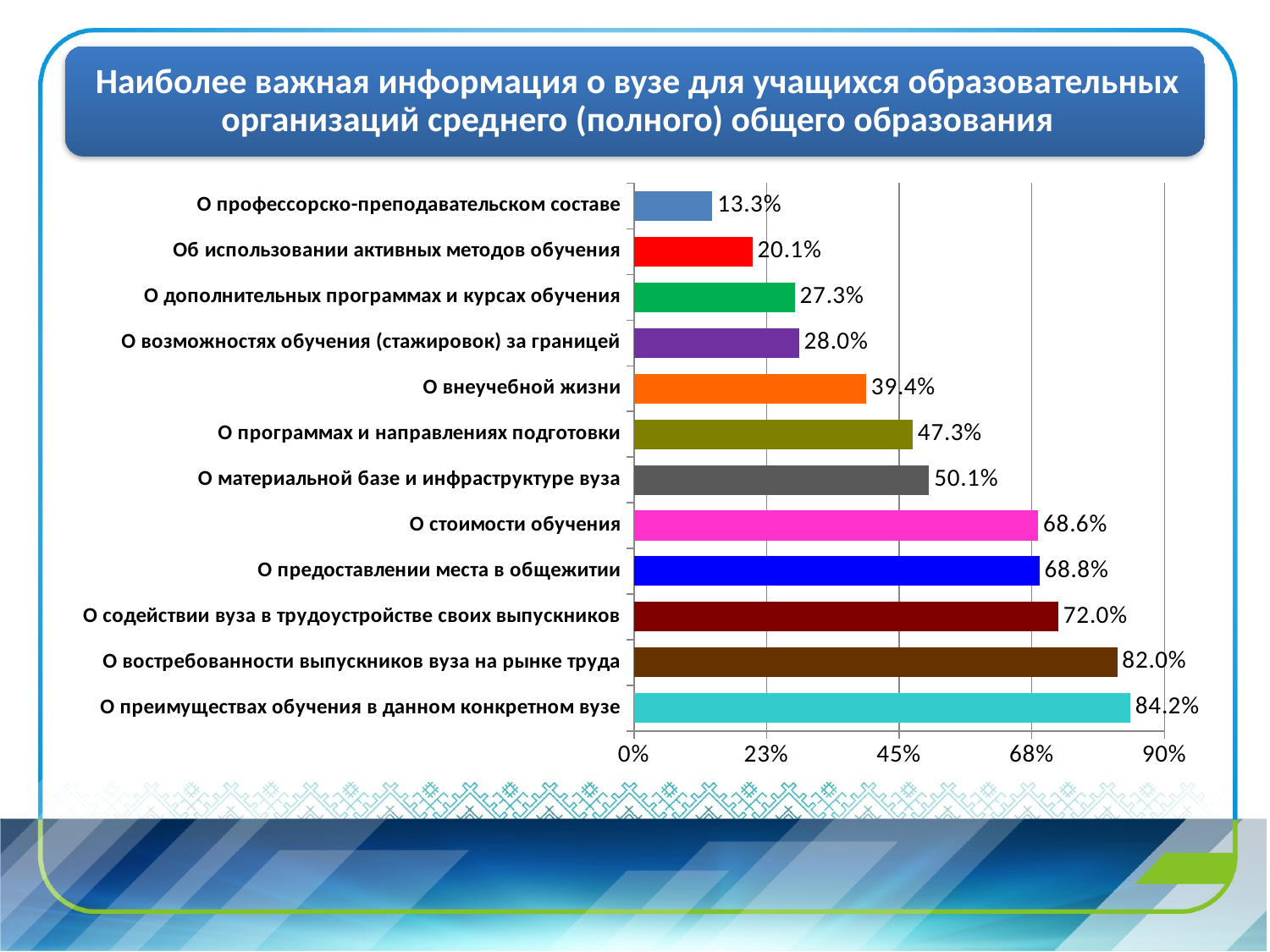
Is the value for «О материальной базе и инфраструктуре вуза» greater or less than 45%? greater Which category has the highest value? О преимуществах обучения в данном конкретном вузе Which is larger: «О программах и направлениях подготовки» or «О внеучебной жизни»? О программах и направлениях подготовки What is the value for «О профессорско-преподавательском составе»? 13.3% What colour is the bar for «О стоимости обучения»? pink Which category has the lowest value? О профессорско-преподавательском составе How many categories are shown in the chart? 12 What kind of chart is shown on the slide? bar chart What is the value for «О внеучебной жизни»? 39.4% What is the difference between «О востребованности выпускников вуза на рынке труда» and «О содействии вуза в трудоустройстве своих выпускников»? 10.0% What is the value for «О стоимости обучения»? 68.6% What is the difference between «О возможностях обучения (стажировок) за границей» and «О дополнительных программах и курсах обучения»? 0.7%